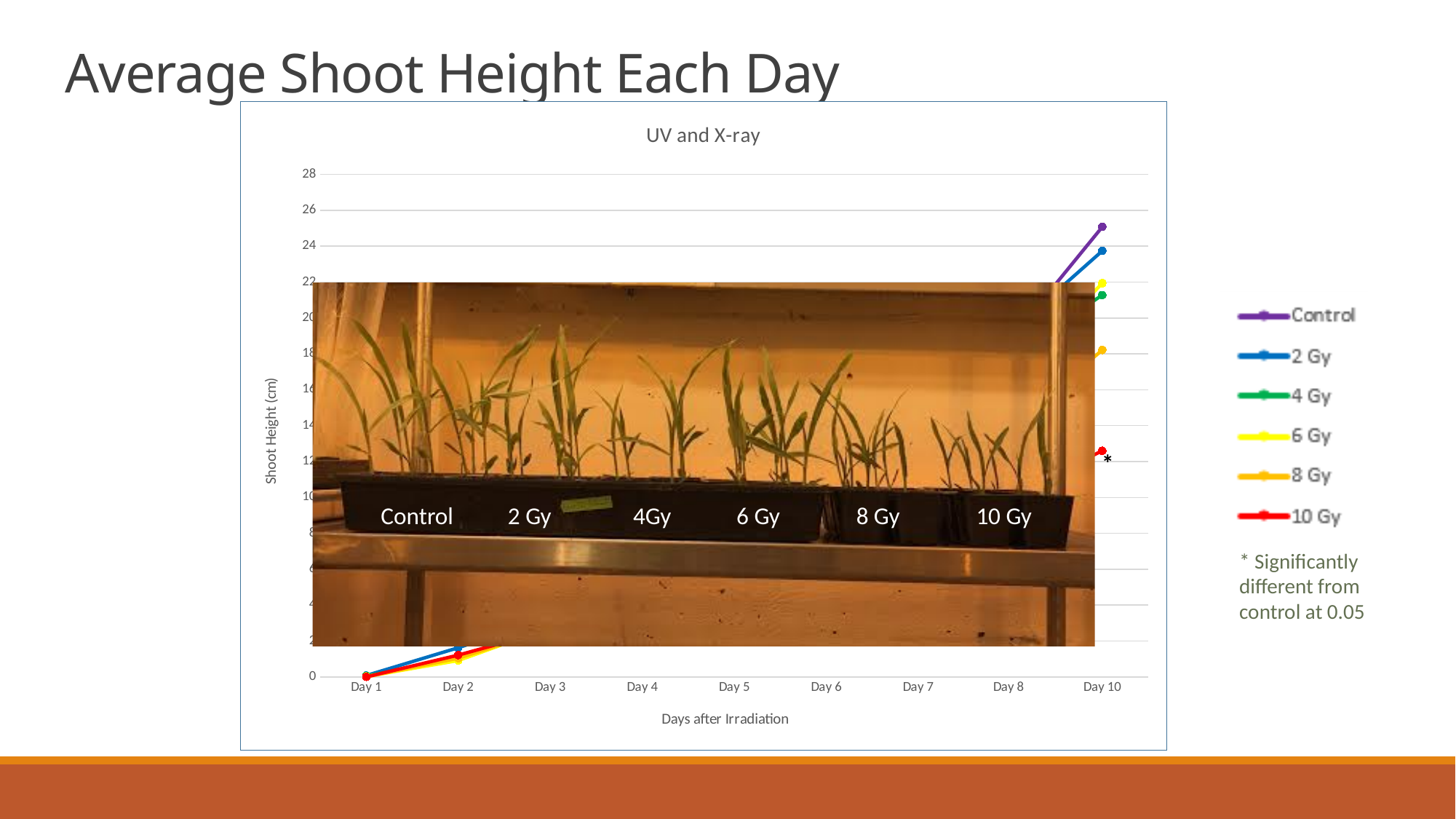
At Day 10, which is larger: the 2 Gy value or the 8 Gy value? 2 Gy Is the 8 Gy value at Day 10 greater or less than 20? less What kind of chart is shown on the slide? line chart How many day categories are shown on the x axis? 9 Which series has the highest shoot height at Day 10? Control How many series does the legend list? 6 Is the 10 Gy value at Day 10 greater or less than 14? less What is the title of the chart? UV and X-ray Which series has the lowest shoot height at Day 10? 10 Gy Is the Control value at Day 10 greater or less than 24? greater Do the shoot height values rise or fall from Day 1 to Day 10? rise What is the label on the y axis of the chart? Shoot Height (cm)